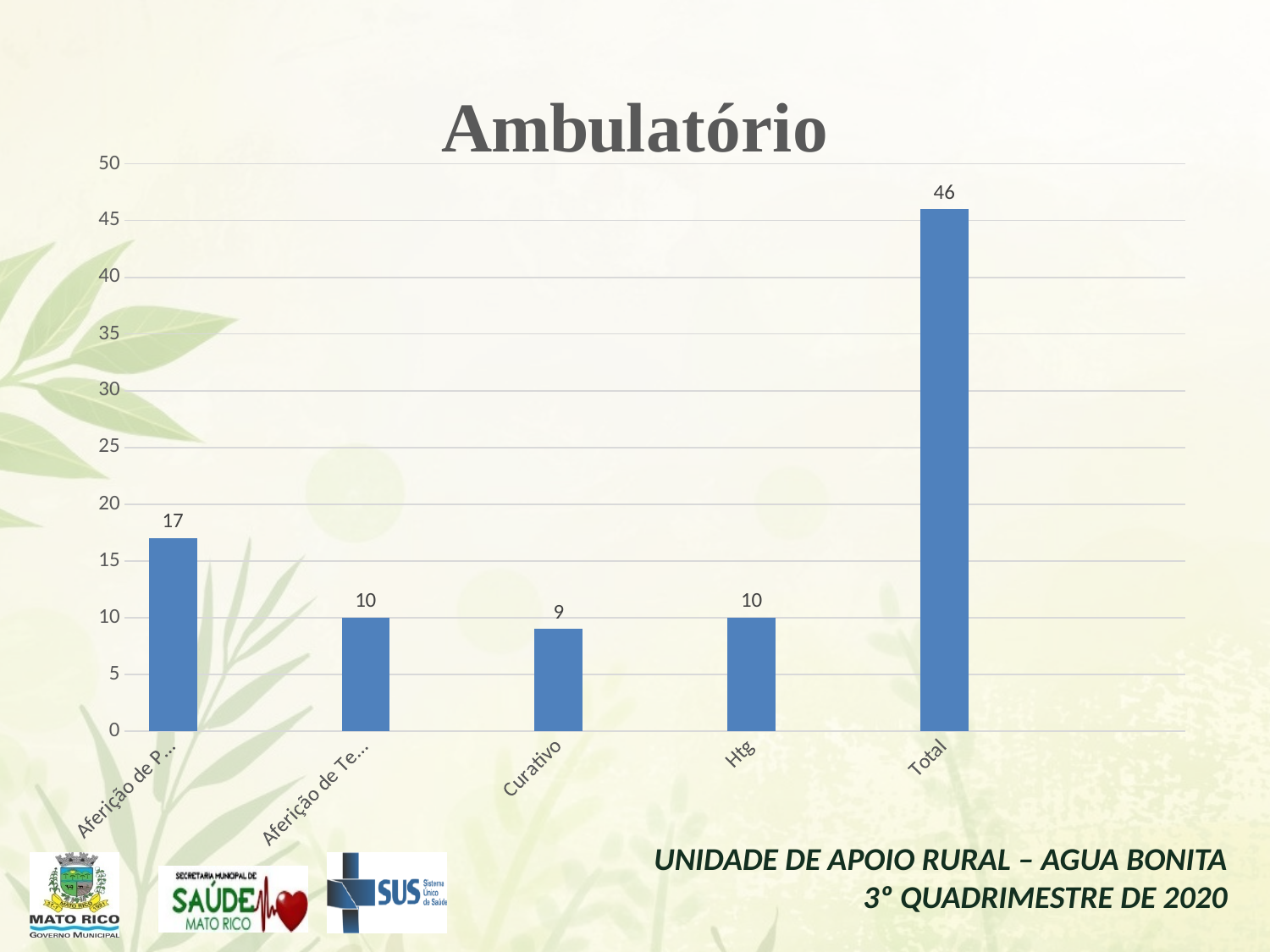
Which category has the highest value? Total Is the value for Total greater or less than 40? greater What is the value of the first bar from the left? 17 What kind of chart is shown on the slide? bar chart Which category has the lowest value? Curativo What is the title of the chart? Ambulatório What is the value for Curativo? 9 What is the value for Total? 46 What is the difference between the values for Total and Htg? 36 How many bars are shown in the chart? 5 Which is larger, the value for Htg or the value for Curativo? Htg What is the value for Htg? 10